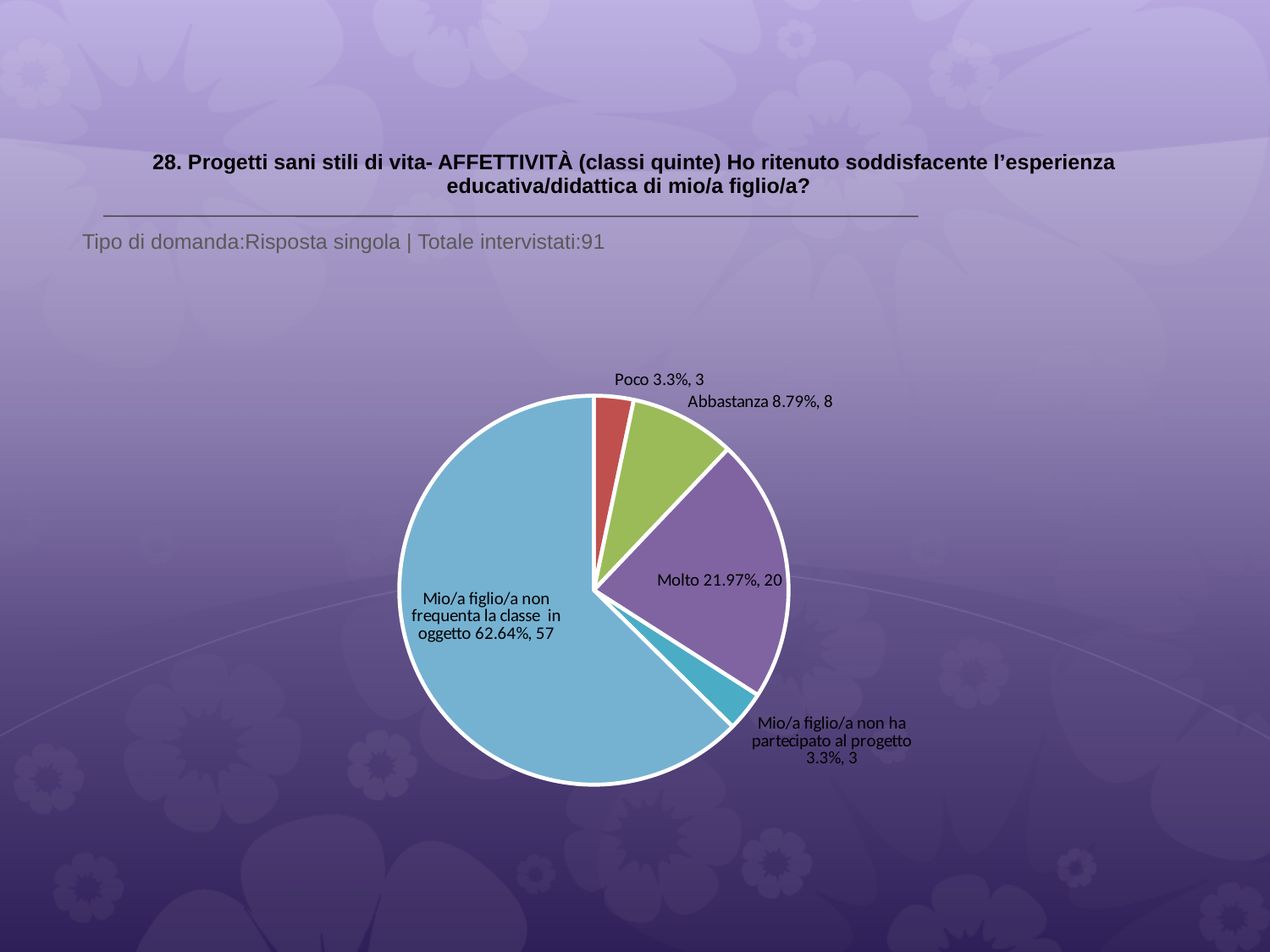
Which category has the largest slice of the pie? Mio/a figlio/a non frequenta la classe in oggetto What percentage share does the slice "Molto" have? 21.97% What percentage share does the slice "Mio/a figlio/a non frequenta la classe in oggetto" have? 62.64% What is the total number of respondents stated on the slide? 91 How many respondents answered "Abbastanza"? 8 How many respondents answered "Poco"? 3 What is the difference in count between "Molto" and "Abbastanza"? 12 How many slices does the pie chart have? 5 What percentage share does the slice "Mio/a figlio/a non ha partecipato al progetto" have? 3.3% What colour is the slice for "Molto"? purple Which is larger, the slice for "Abbastanza" or the slice for "Poco"? Abbastanza What kind of chart is shown on the slide? pie chart